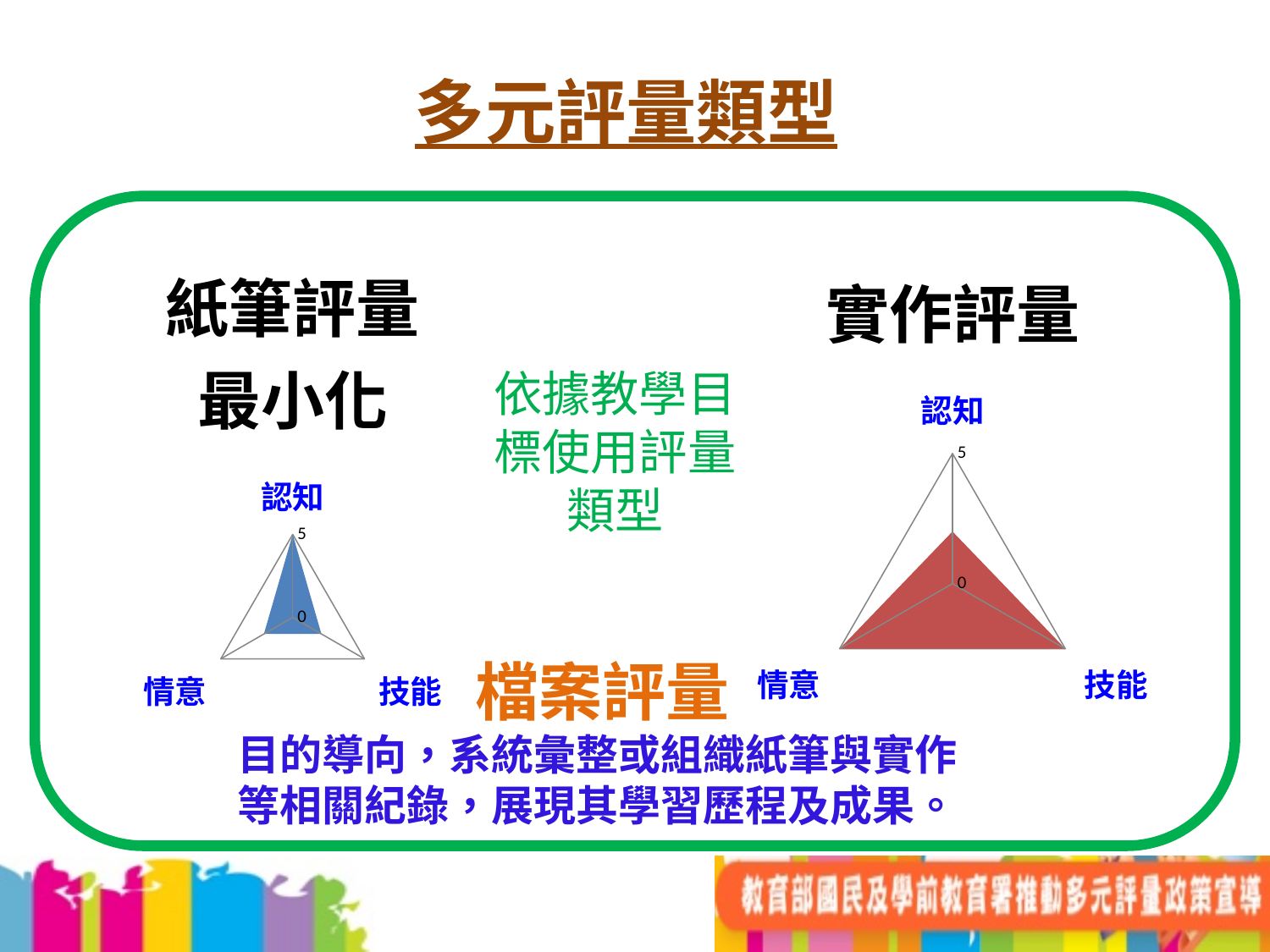
What kind of chart is shown under 實作評量 on the right of the slide? Radar chart In the left chart (紙筆評量), what value does 認知 reach? 5 In the left chart (紙筆評量), which is larger, the value for 認知 or the value for 技能? 認知 In the right chart (實作評量), is the value for 認知 greater or less than 5? less What colour is the filled area in the right chart (實作評量)? Red In the right chart (實作評量), how many axes (categories) does the radar chart have? 3 In the left chart (紙筆評量), is the value for 情意 greater or less than 5? less In the left chart (紙筆評量), which category has the highest value? 認知 In the right chart (實作評量), which category has the lowest value? 認知 In the left chart (紙筆評量), how many axes (categories) does the radar chart have? 3 What kind of chart is shown under 紙筆評量 on the left of the slide? Radar chart In the right chart (實作評量), what value does 技能 reach? 5